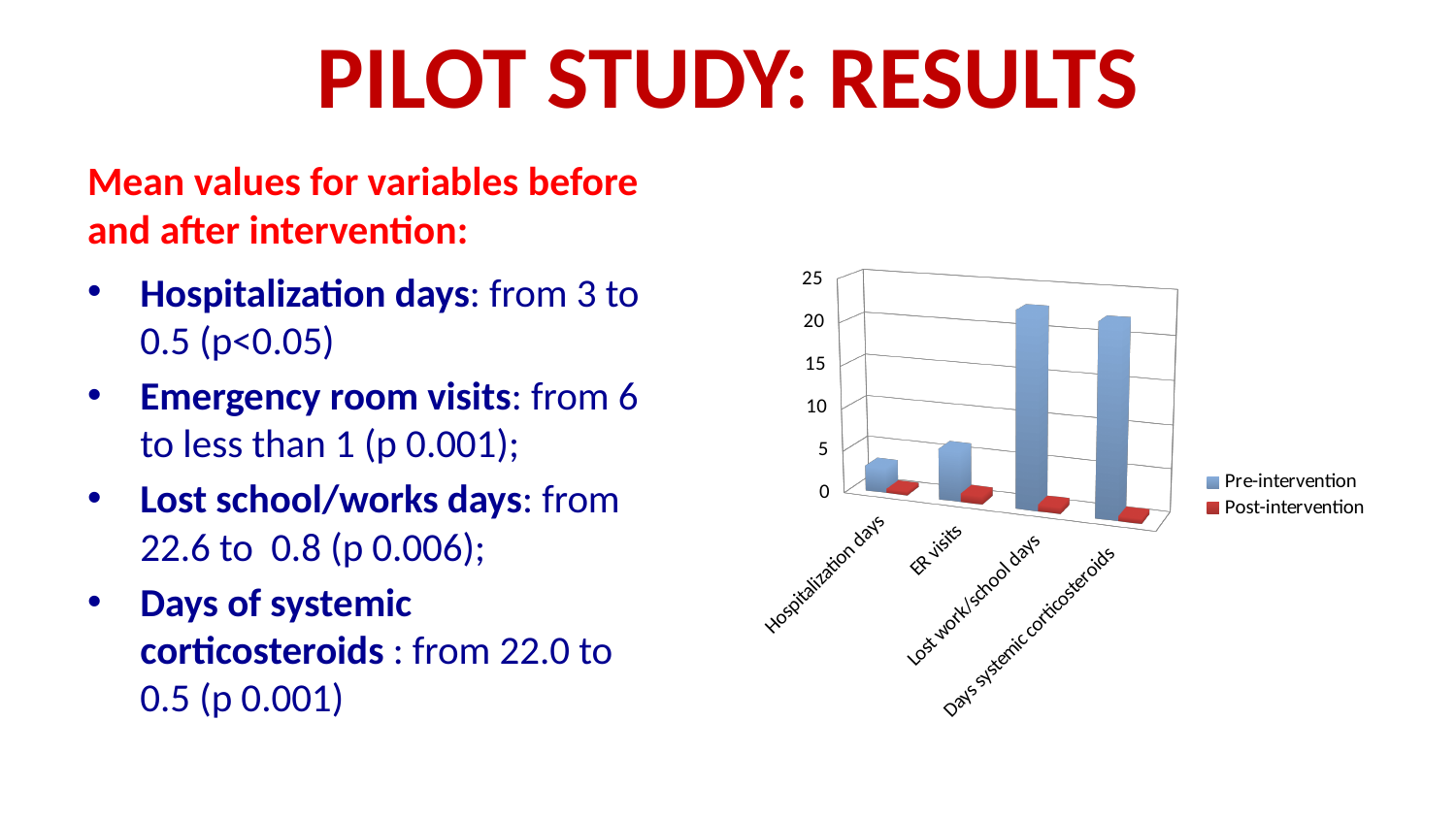
Is the Pre-intervention value for Lost work/school days greater or less than 20? greater How many categories are shown on the x axis of the chart? 4 Which is larger, the Pre-intervention value for ER visits or for Hospitalization days? ER visits Is the Pre-intervention value for Hospitalization days greater or less than 5? less What kind of chart is shown on the slide? bar chart Which series is shown in red in the chart? Post-intervention Is the Post-intervention value for Lost work/school days greater or less than 5? less Which category has the lowest Pre-intervention value? Hospitalization days Which series is shown in blue in the chart? Pre-intervention How many series does the chart legend list? 2